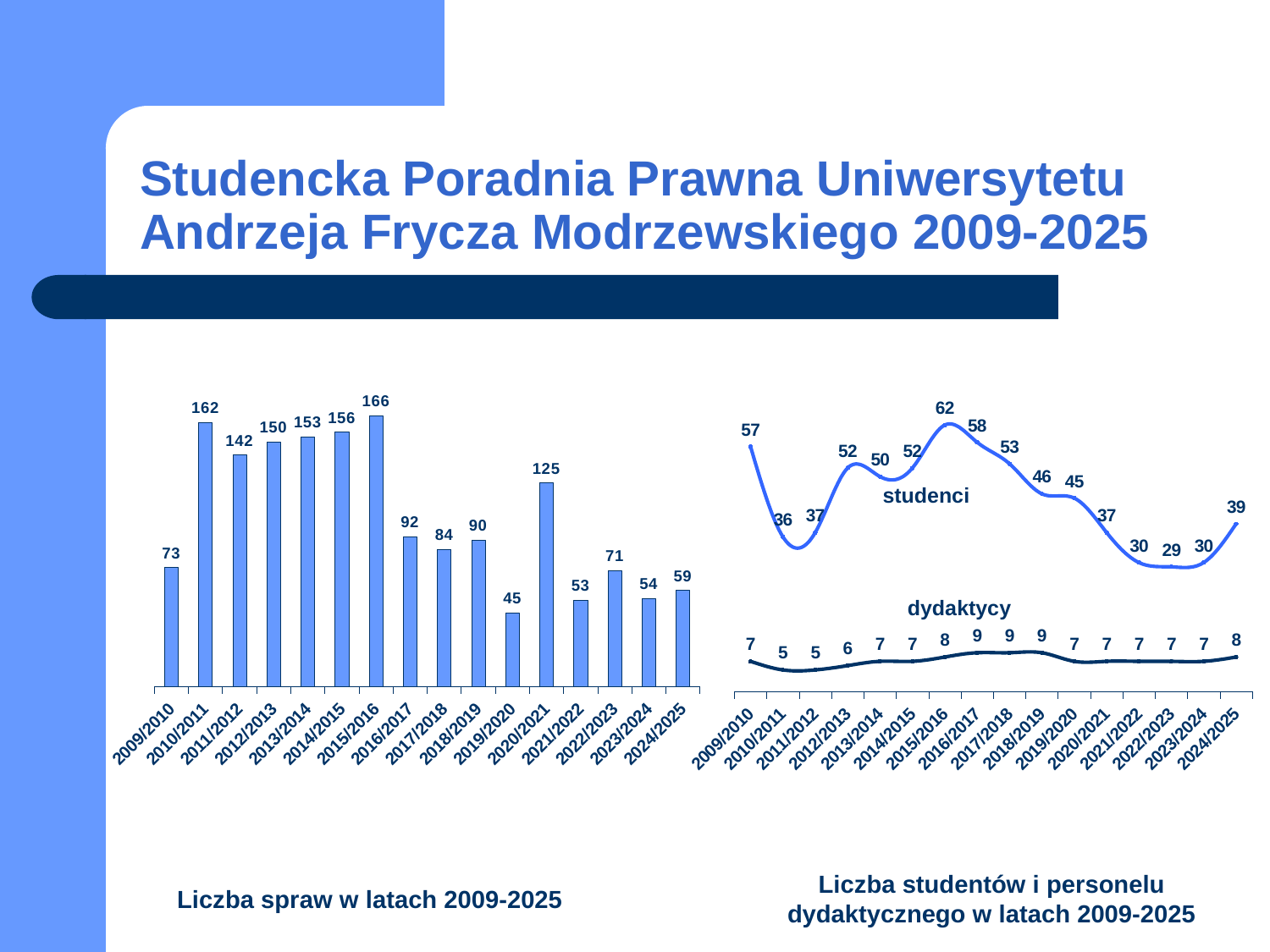
In the chart 'Liczba studentów i personelu dydaktycznego w latach 2009-2025', in which year is the studenci value lowest? 2022/2023 In the chart 'Liczba studentów i personelu dydaktycznego w latach 2009-2025', how many series are plotted? 2 What kind of chart is 'Liczba spraw w latach 2009-2025'? Bar chart In the chart 'Liczba spraw w latach 2009-2025', which year has the lowest value? 2019/2020 In the chart 'Liczba spraw w latach 2009-2025', which year has the highest value? 2015/2016 In the chart 'Liczba studentów i personelu dydaktycznego w latach 2009-2025', which is larger: the studenci value for 2009/2010 or for 2024/2025? 2009/2010 In the chart 'Liczba studentów i personelu dydaktycznego w latach 2009-2025', what is the value for dydaktycy in 2024/2025? 8 In the chart 'Liczba studentów i personelu dydaktycznego w latach 2009-2025', what is the value for studenci in 2015/2016? 62 In the chart 'Liczba spraw w latach 2009-2025', what is the value for 2015/2016? 166 What kind of chart is 'Liczba studentów i personelu dydaktycznego w latach 2009-2025'? Line chart In the chart 'Liczba spraw w latach 2009-2025', what is the difference between the values for 2010/2011 and 2009/2010? 89 In the chart 'Liczba spraw w latach 2009-2025', how many bars are plotted? 16